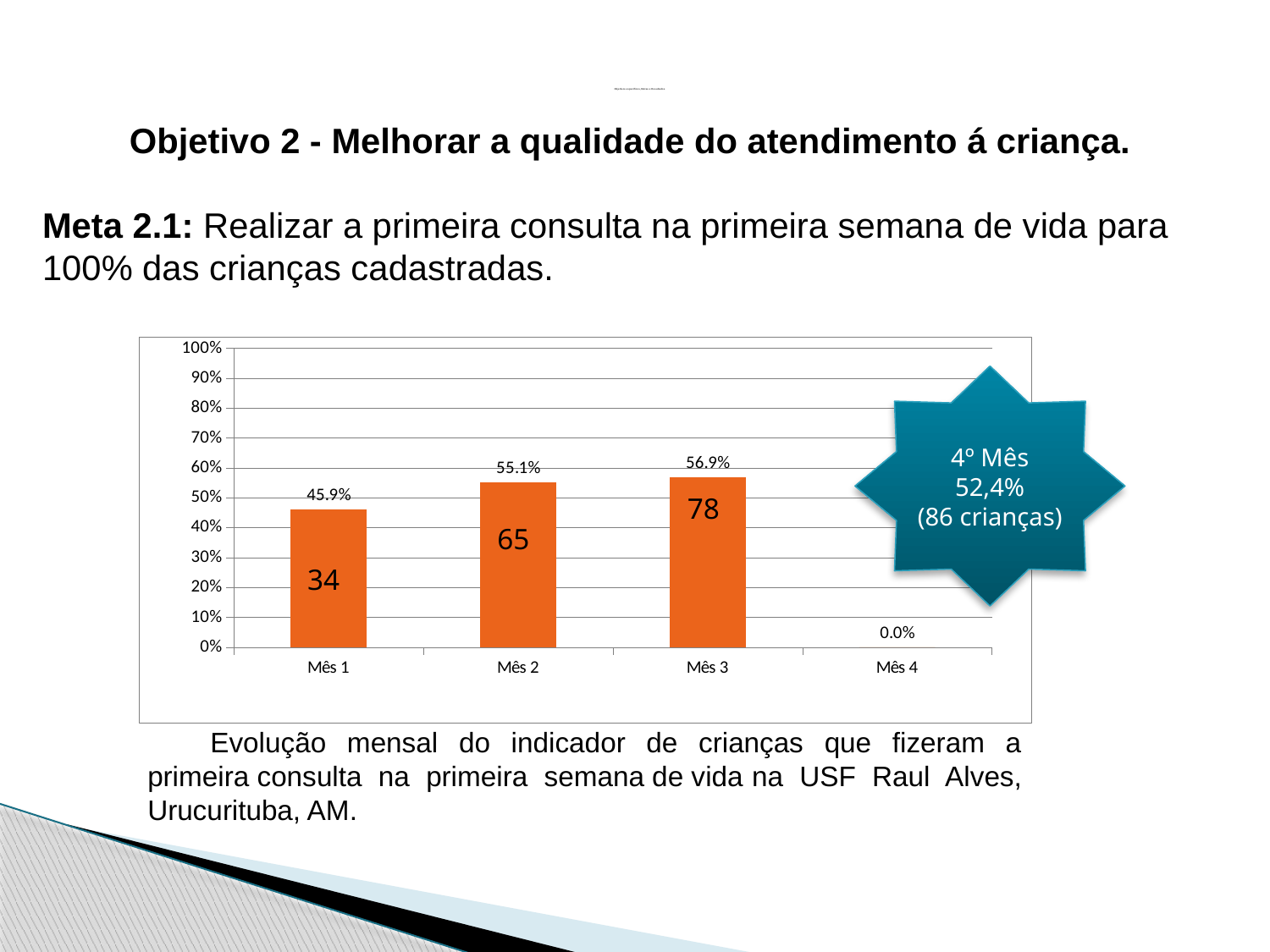
What percentage is shown for Mês 2? 55.1% Which month has the lowest percentage in the chart? Mês 4 What percentage is shown for Mês 1? 45.9% What percentage is shown for Mês 4 in the chart? 0.0% What is the difference in percentage between Mês 3 and Mês 1? 11.0% What number is printed inside the bar for Mês 1? 34 What kind of chart is shown on the slide? Bar chart What percentage is shown for Mês 3? 56.9% Which month has the highest percentage in the chart? Mês 3 How many months are shown on the x axis of the chart? 4 Which is larger, the percentage for Mês 2 or for Mês 1? Mês 2 What number is printed inside the bar for Mês 3? 78